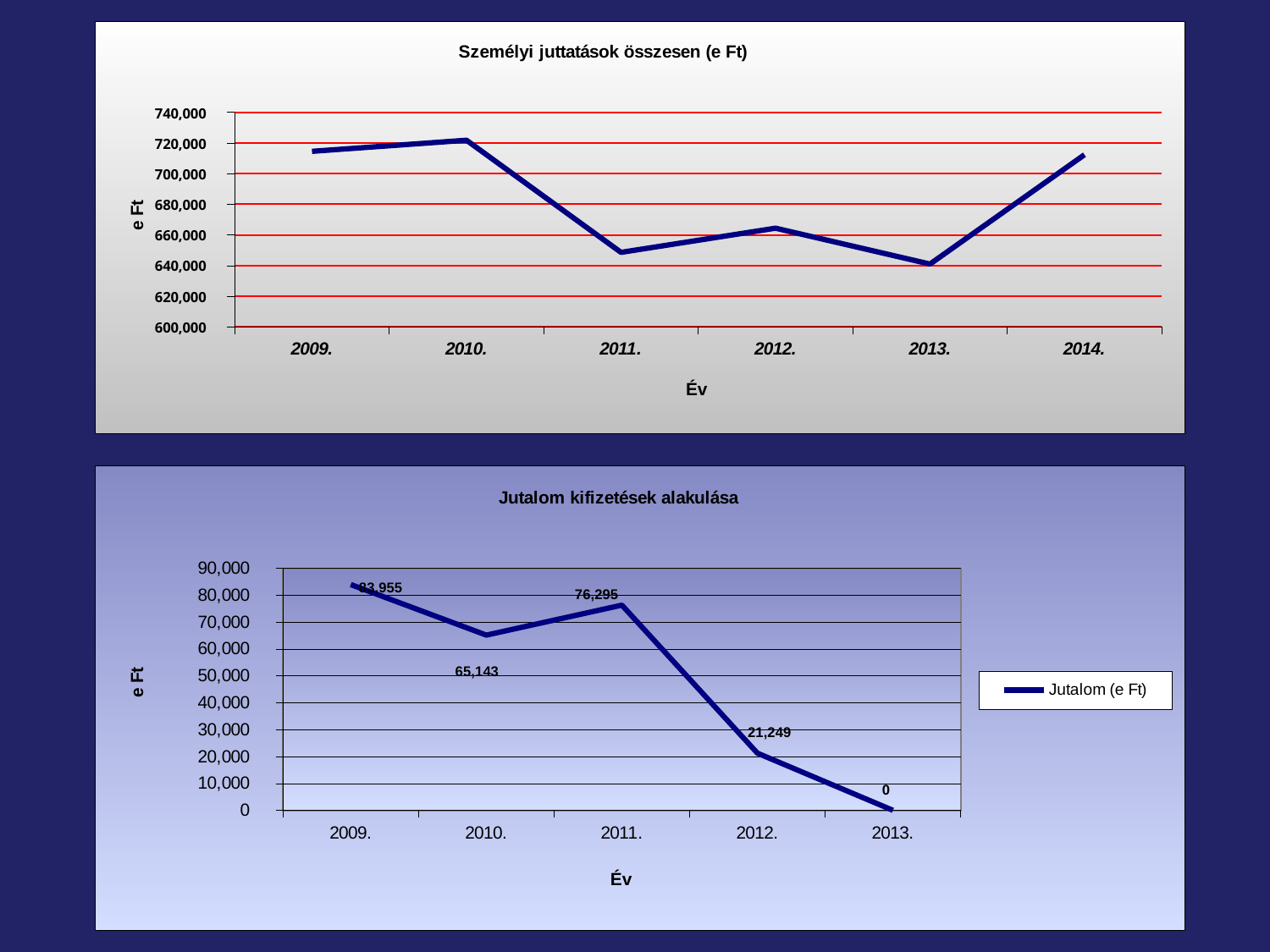
In the top chart 'Személyi juttatások összesen (e Ft)', how many years are plotted on the x axis? 6 In the top chart 'Személyi juttatások összesen (e Ft)', is the value for 2010 greater or less than 700,000? greater In the bottom chart 'Jutalom kifizetések alakulása', what is the value for 2009? 83,955 In the bottom chart 'Jutalom kifizetések alakulása', what is the difference between the values for 2009 and 2010? 18,812 In the bottom chart 'Jutalom kifizetések alakulása', which year has the lowest value? 2013. In the top chart 'Személyi juttatások összesen (e Ft)', is the value for 2011 greater or less than 660,000? less In the bottom chart 'Jutalom kifizetések alakulása', what is the label of the series shown in the legend? Jutalom (e Ft) In the top chart 'Személyi juttatások összesen (e Ft)', is the value for 2012 greater or less than 680,000? less In the bottom chart 'Jutalom kifizetések alakulása', how many series does the legend list? 1 In the top chart 'Személyi juttatások összesen (e Ft)', which is larger, the value for 2009 or the value for 2011? 2009 What type of chart is the top chart titled 'Személyi juttatások összesen (e Ft)'? line chart In the bottom chart 'Jutalom kifizetések alakulása', what is the value for 2012? 21,249